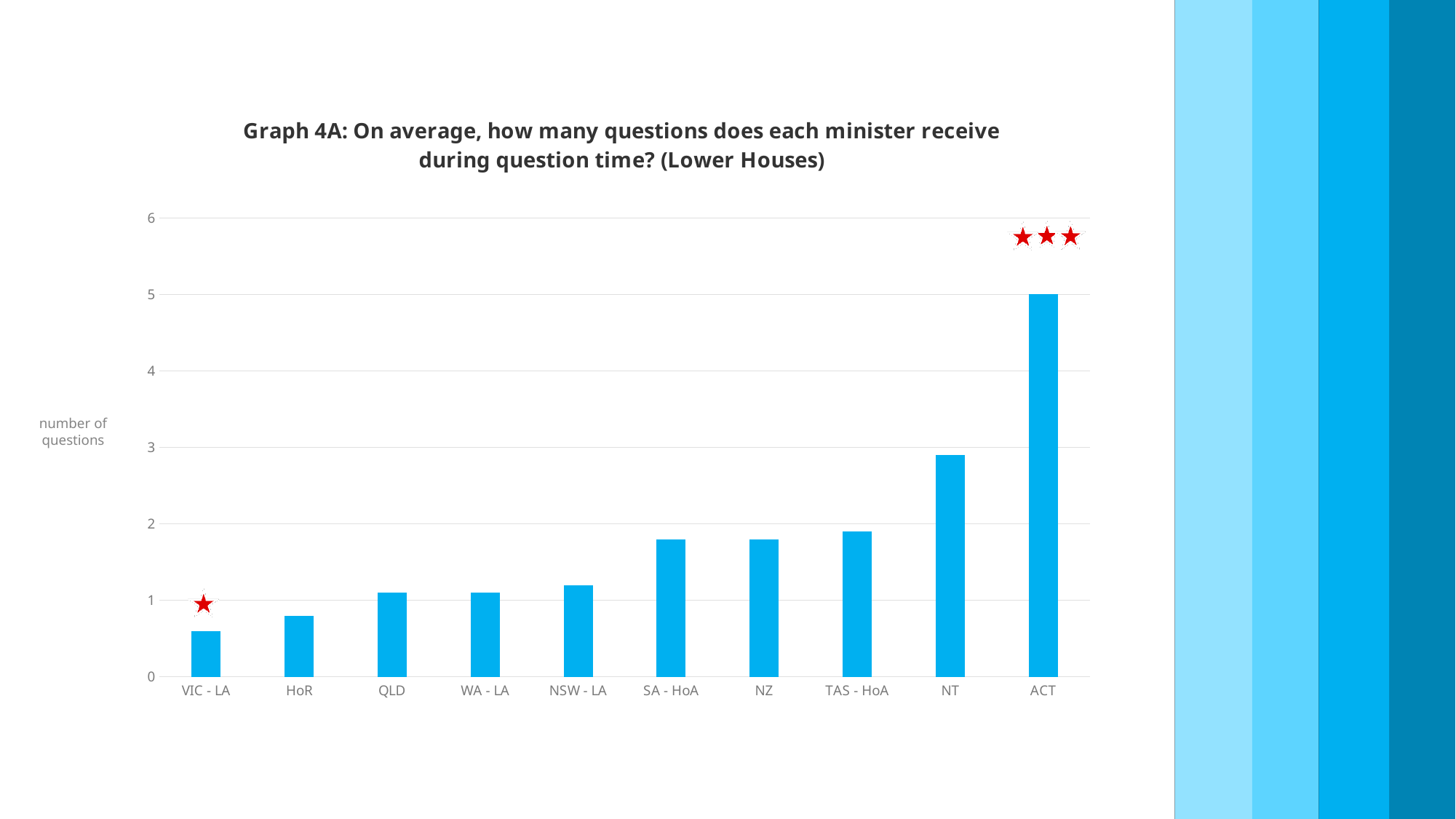
Is the value for SA - HoA greater or less than 2? less What is the average number of questions per minister for ACT? 5 Is the value for VIC - LA greater or less than 1? less Which has a higher value, NT or TAS - HoA? NT Do the values generally rise or fall moving from left to right along the x axis? rise Is the value for NT greater or less than 2? greater What is the label on the vertical axis? number of questions Which parliament has the lowest average number of questions per minister? VIC - LA Which parliament has the highest average number of questions per minister? ACT How many categories (parliaments) are plotted on the x axis? 10 What type of chart is shown on the slide? bar chart